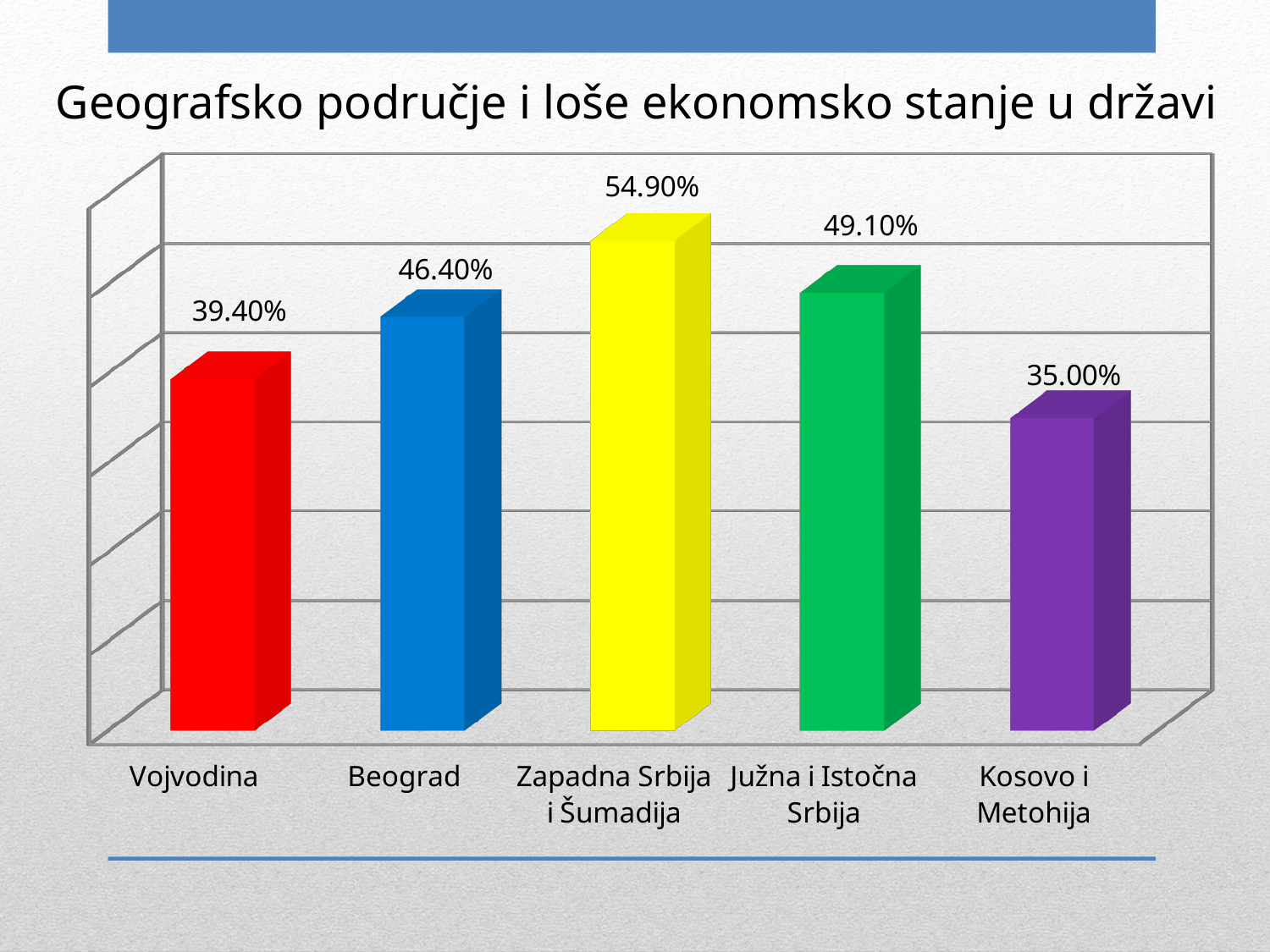
Which category has the highest value? Zapadna Srbija i Šumadija What is the value for Beograd? 46.40% Which category has the lowest value? Kosovo i Metohija What is the value for Zapadna Srbija i Šumadija? 54.90% How many categories are shown on the chart? 5 Which is larger, the value for Beograd or the value for Južna i Istočna Srbija? Južna i Istočna Srbija What is the difference between the values for Zapadna Srbija i Šumadija and Južna i Istočna Srbija? 5.80% What is the value for Kosovo i Metohija? 35.00% What kind of chart is shown on the slide? Bar chart What is the difference between the values for Beograd and Vojvodina? 7.00% What is the value for Vojvodina? 39.40% What is the title of the chart? Geografsko područje i loše ekonomsko stanje u državi